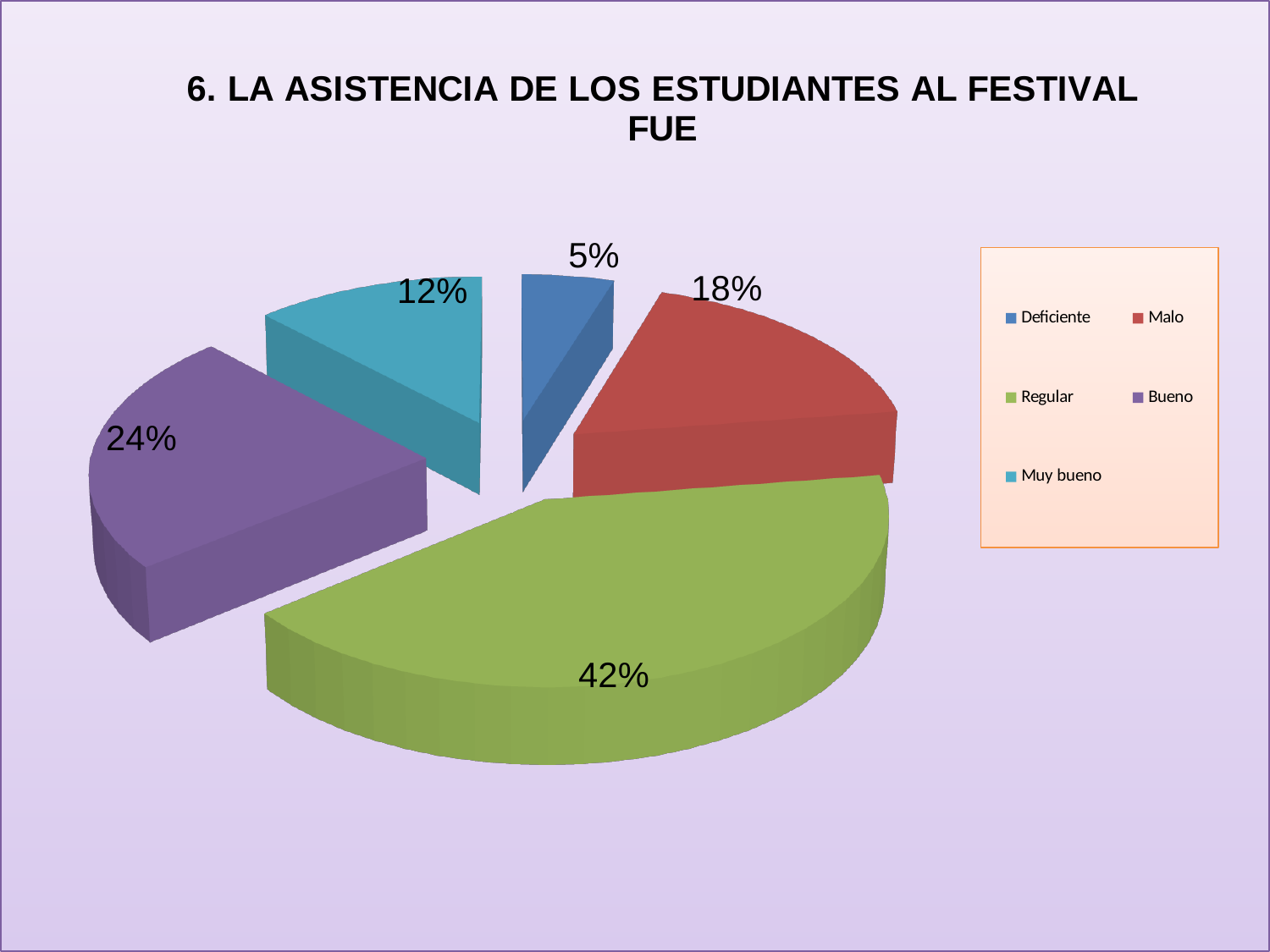
What percentage of the pie is labelled Regular? 42% What kind of chart is shown on the slide? Pie chart How many categories does the legend list? 5 What is the difference in percentage points between the Regular and Bueno slices? 18 What percentage of the pie is labelled Malo? 18% What colour is the Bueno slice? Purple What percentage of the pie is labelled Bueno? 24% What percentage of the pie is labelled Deficiente? 5% Which category has the largest share of the pie? Regular Which category has the smallest share of the pie? Deficiente Which slice is larger, Malo or Muy bueno? Malo What percentage of the pie is labelled Muy bueno? 12%